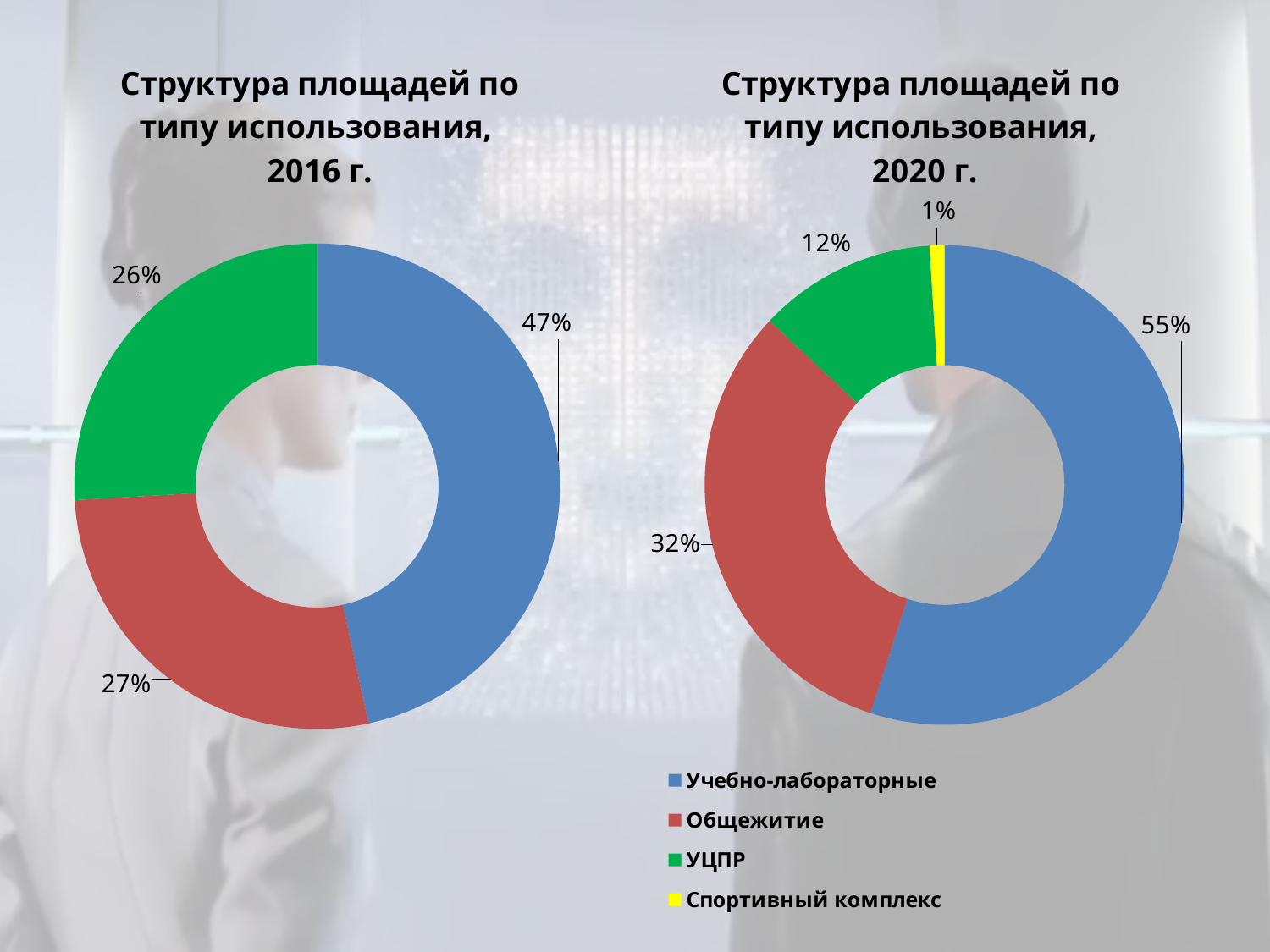
In the chart 'Структура площадей по типу использования, 2016 г.', what share does Общежитие have? 27% In the chart 'Структура площадей по типу использования, 2020 г.', what share does Спортивный комплекс have? 1% In the chart 'Структура площадей по типу использования, 2020 г.', which category has the largest share? Учебно-лабораторные In the chart 'Структура площадей по типу использования, 2020 г.', which category has the smallest share? Спортивный комплекс In the chart 'Структура площадей по типу использования, 2016 г.', what share does УЦПР have? 26% What type of chart is used on the slide for the 2016 and 2020 area structure? Doughnut (pie) chart In the chart 'Структура площадей по типу использования, 2020 г.', what is the difference between the shares of Общежитие and УЦПР? 20% By how many percentage points did the share of Учебно-лабораторные areas change from the 2016 chart to the 2020 chart? 8% How many categories are shown in the chart 'Структура площадей по типу использования, 2020 г.'? 4 How many entries does the legend on the slide list? 4